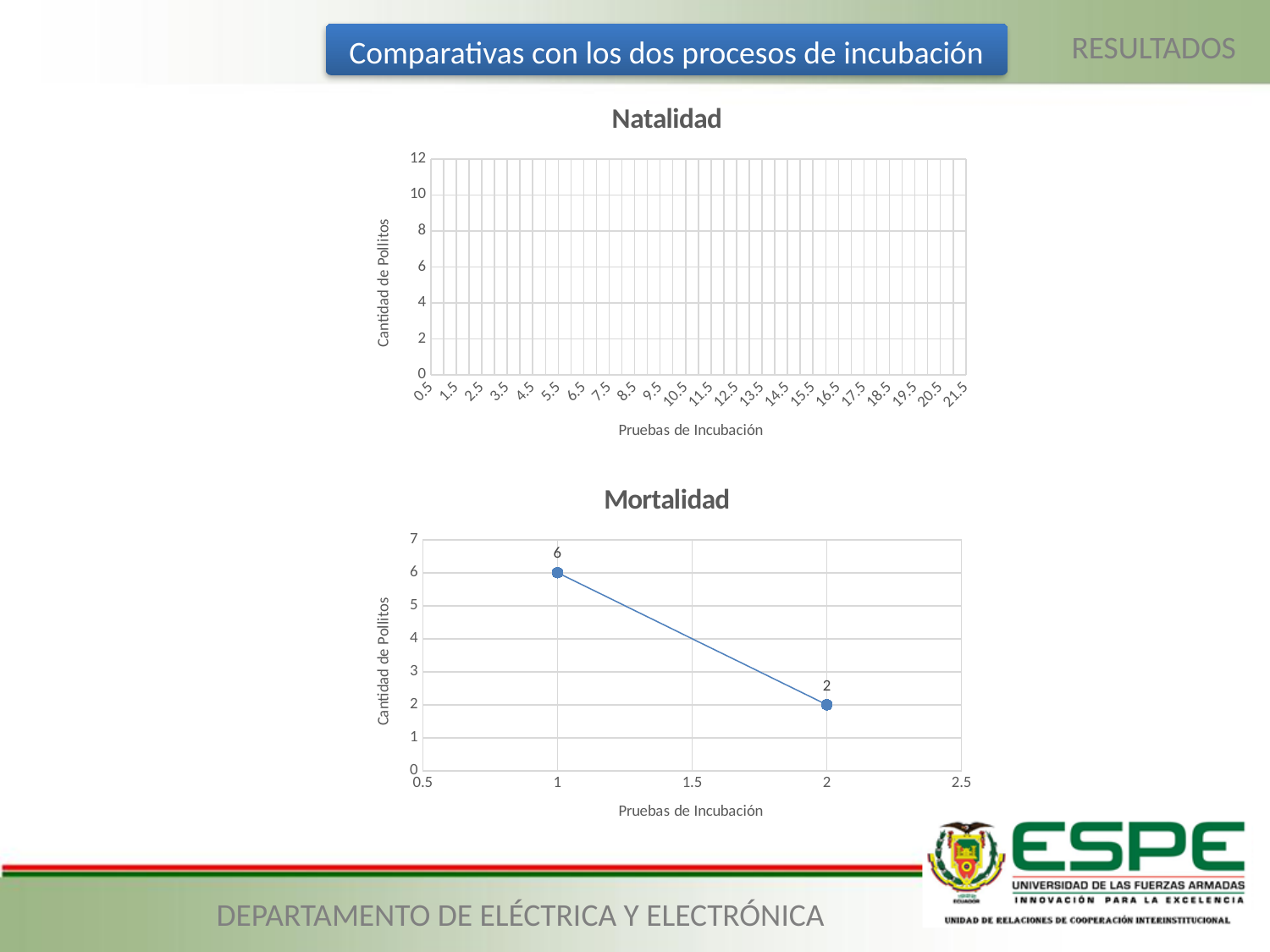
In the Mortalidad chart, do the values rise or fall from test 1 to test 2? fall In the Mortalidad chart, what is the difference between the values at test 1 and test 2? 4 In the Mortalidad chart, which incubation test has the lowest value? 2 In the Mortalidad chart, which incubation test has the highest value? 1 In the Mortalidad chart, what is the value at incubation test 2? 2 In the Mortalidad chart, which is larger: the value at test 1 or the value at test 2? test 1 What kind of chart is the Mortalidad chart? line chart What is the x-axis title of the Natalidad chart? Pruebas de Incubación In the Mortalidad chart, what is the value at incubation test 1? 6 What is the y-axis title of the Mortalidad chart? Cantidad de Pollitos In the Mortalidad chart, is the value at test 1 greater or less than 5? greater How many data points are plotted in the Mortalidad chart? 2